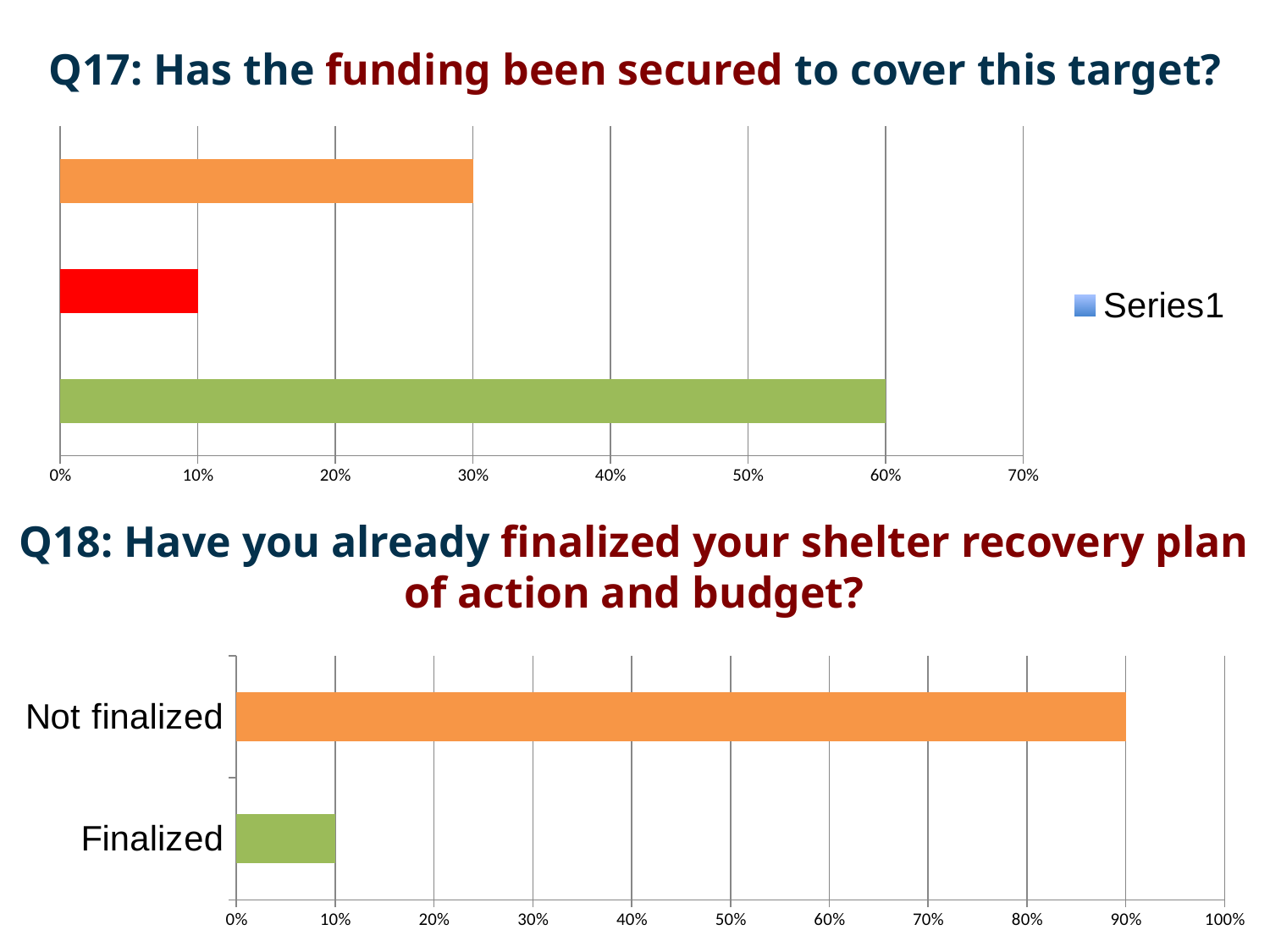
In the Q18 chart, what is the value for Finalized? 10% In the Q18 chart, which category has the highest value? Not finalized In the Q18 chart, which is larger, the value for Finalized or the value for Not finalized? Not finalized How many bars are shown in the Q17 chart? 3 In the Q18 chart, what is the difference between the values for Not finalized and Finalized? 80% What kind of chart is the Q17 chart? bar chart In the Q18 chart, what is the value for Not finalized? 90% What is the legend entry shown in the Q17 chart? Series1 How many categories are shown in the Q18 chart? 2 In the Q18 chart, which category has the lowest value? Finalized In the Q18 chart, is the value for Not finalized greater or less than 50%? greater How many series does the legend of the Q17 chart list? 1